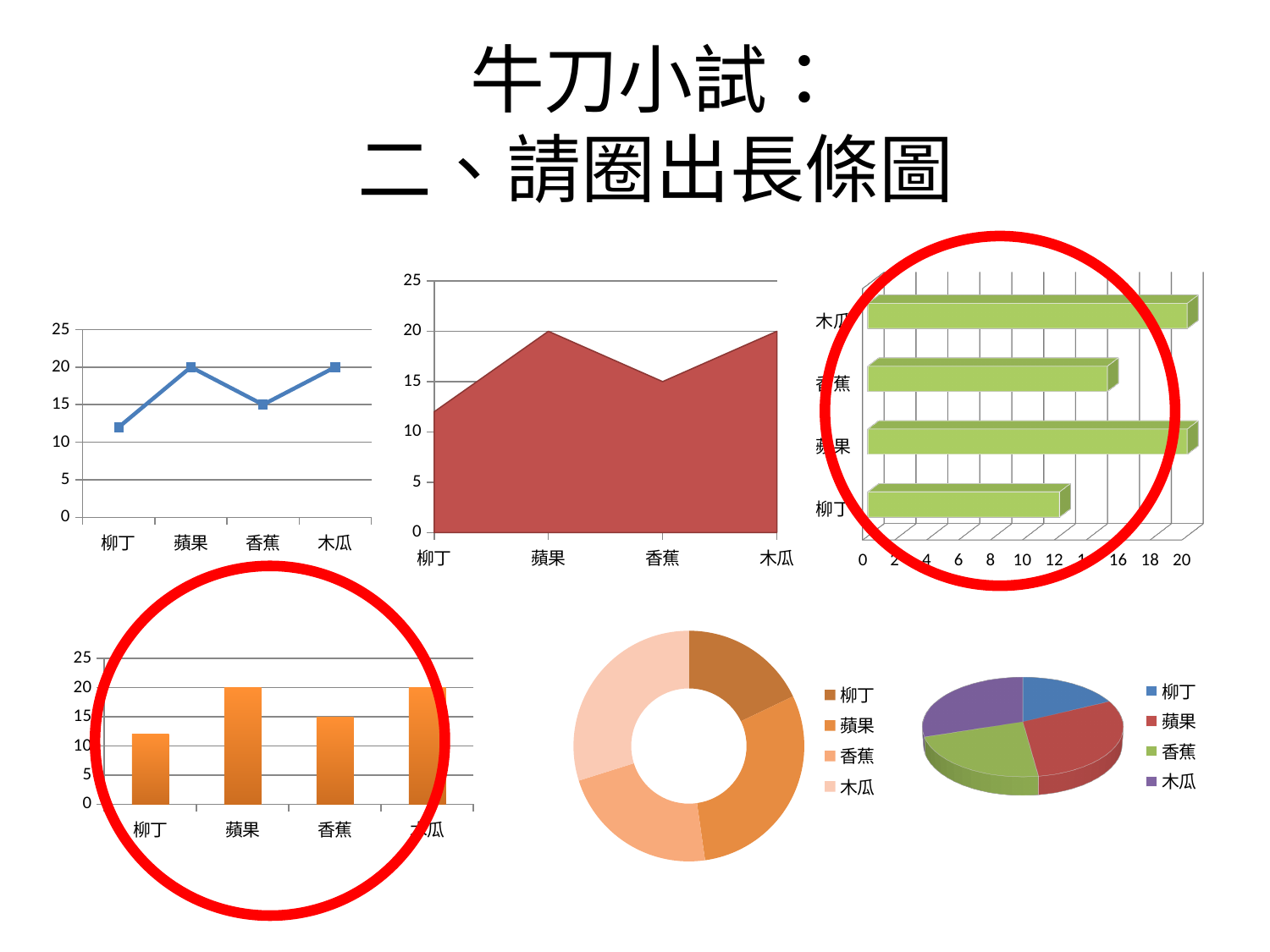
How many entries does the legend of the bottom-right pie chart list? 4 In the top-right horizontal bar chart, what is the value for 柳丁? 12 What kind of chart is the top-middle chart on the slide? area chart In the top-left line chart, what is the value for 香蕉? 15 What kind of chart is the bottom-left chart circled in red? bar chart What are the legend entries of the bottom-middle doughnut chart? 柳丁, 蘋果, 香蕉, 木瓜 In the top-left line chart, is the value for 柳丁 greater or less than 15? less In the bottom-left bar chart, how many categories are shown on the x axis? 4 What kind of chart is the top-left chart on the slide? line chart In the bottom-left bar chart, which is larger, the value for 蘋果 or the value for 香蕉? 蘋果 In the bottom-left bar chart, which category has the lowest value? 柳丁 In the top-right horizontal bar chart, is the value for 香蕉 greater or less than 10? greater